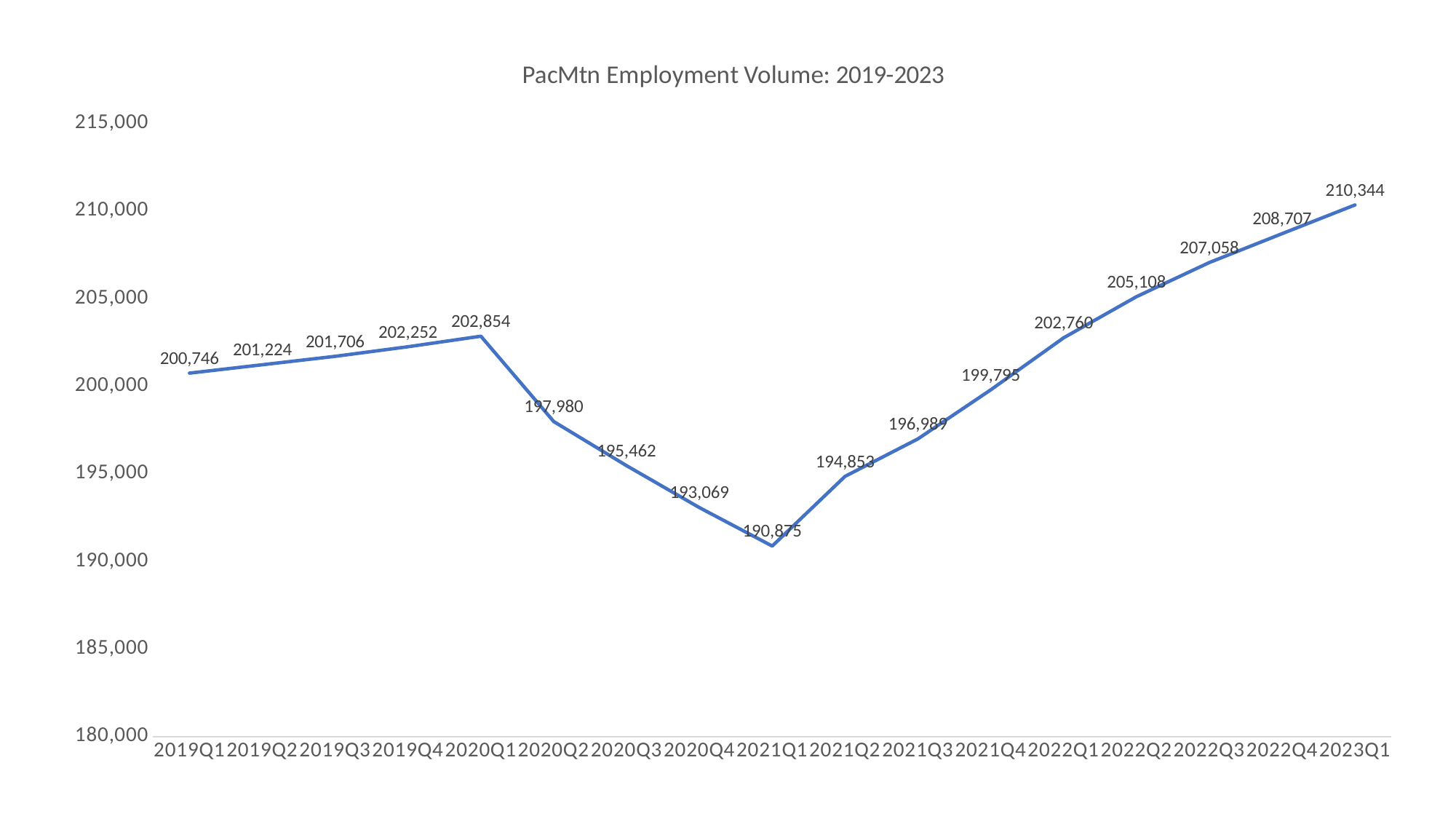
What is the employment volume for 2020Q1? 202,854 How many quarters are plotted on the chart? 17 What is the title of the chart? PacMtn Employment Volume: 2019-2023 Which quarter has the lowest employment volume? 2021Q1 What is the employment volume for 2022Q3? 207,058 What kind of chart is shown on the slide? line chart Which is larger, the employment volume in 2019Q1 or in 2021Q4? 2019Q1 What is the difference between the employment volume in 2020Q1 and in 2020Q2? 4,874 Which quarter has the highest employment volume? 2023Q1 Is the employment volume for 2022Q2 greater or less than 205,000? greater What is the employment volume for 2021Q1? 190,875 What is the difference between the employment volume in 2023Q1 and in 2021Q1? 19,469